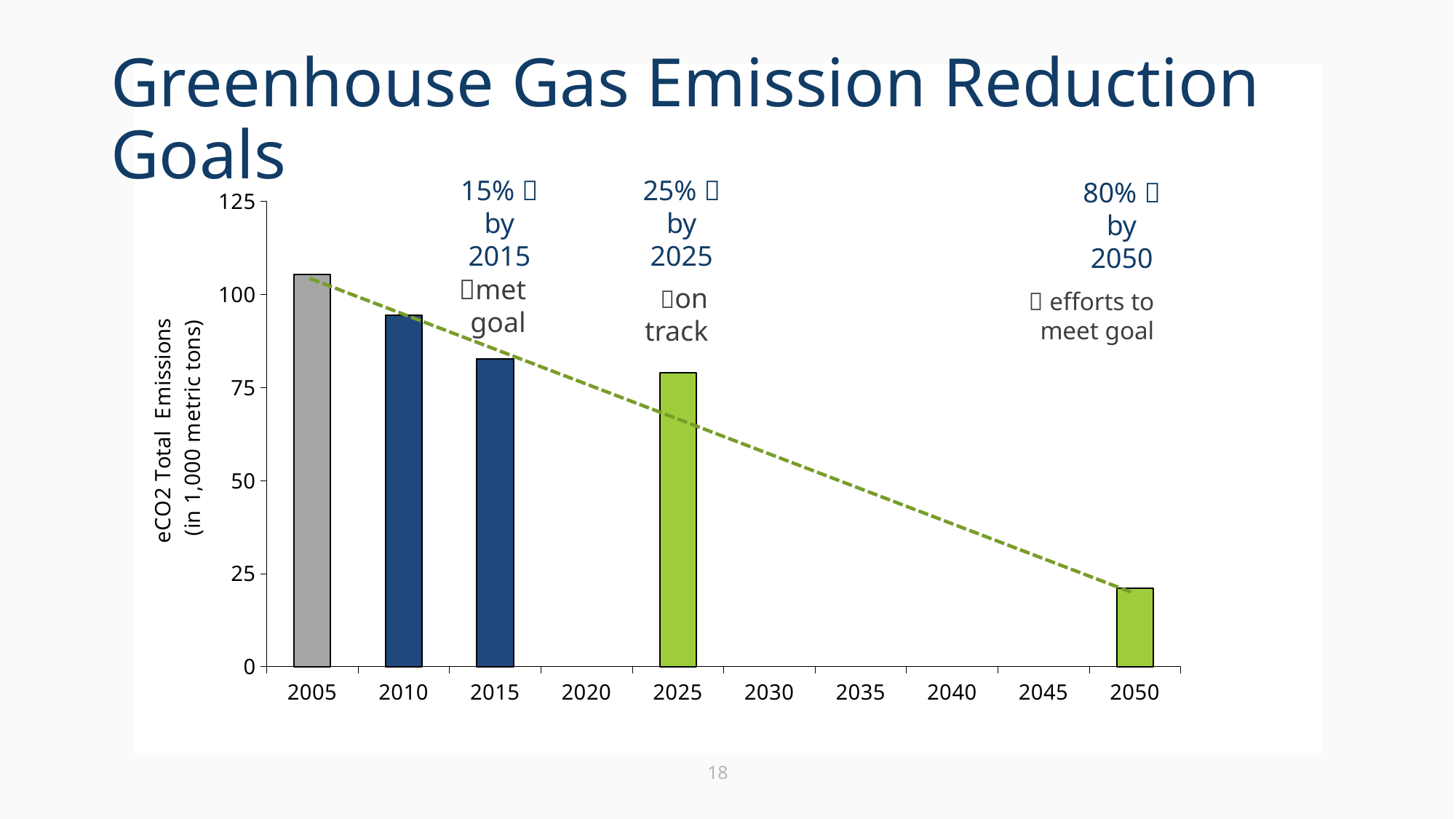
Which year has the lowest eCO2 total emissions bar? 2050 What reduction goal is annotated above the 2050 bar? 80% by 2050 Do the emission values rise or fall from 2005 to 2050? fall Which is larger, the bar for 2010 or the bar for 2015? 2010 What kind of chart is shown on the slide? bar chart What is the y-axis title of the chart? eCO2 Total Emissions (in 1,000 metric tons) Is the value for 2050 greater or less than 25? less Is the value for 2005 greater or less than 100? greater Is the value for 2010 greater or less than 100? less Which year has the highest eCO2 total emissions bar? 2005 How many bars are plotted on the chart? 5